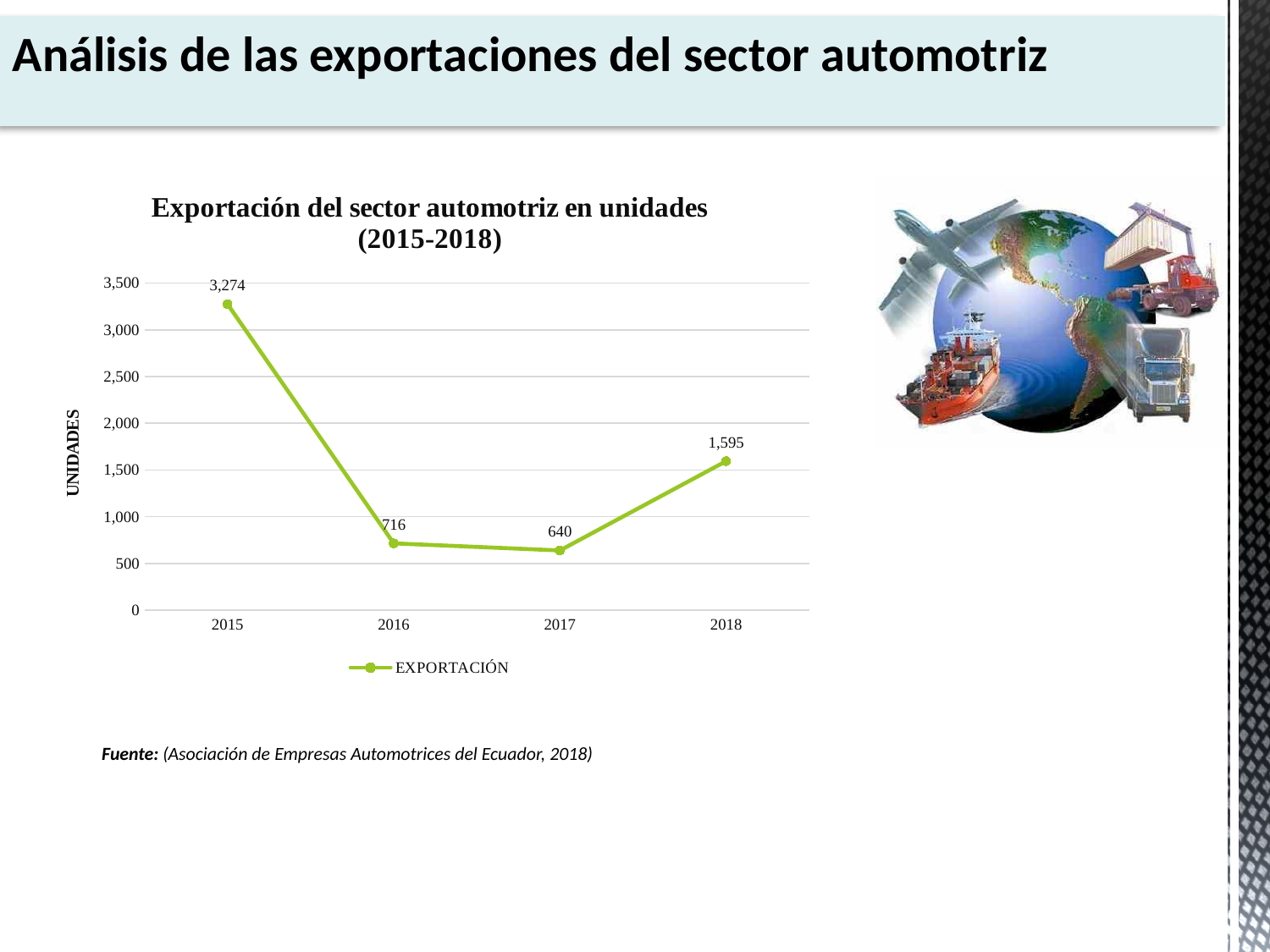
What kind of chart is shown on the slide? line chart Which year has the lowest export value? 2017 Which year has the highest export value? 2015 What is the export value for 2015? 3,274 What is the label on the vertical axis of the chart? UNIDADES What is the export value for 2018? 1,595 How many years are plotted on the chart? 4 What is the difference between the export values for 2018 and 2017? 955 Is the export value for 2018 greater or less than 2,000? less What is the difference between the export values for 2015 and 2016? 2,558 What is the export value for 2017? 640 Which is larger, the export value for 2016 or for 2018? 2018